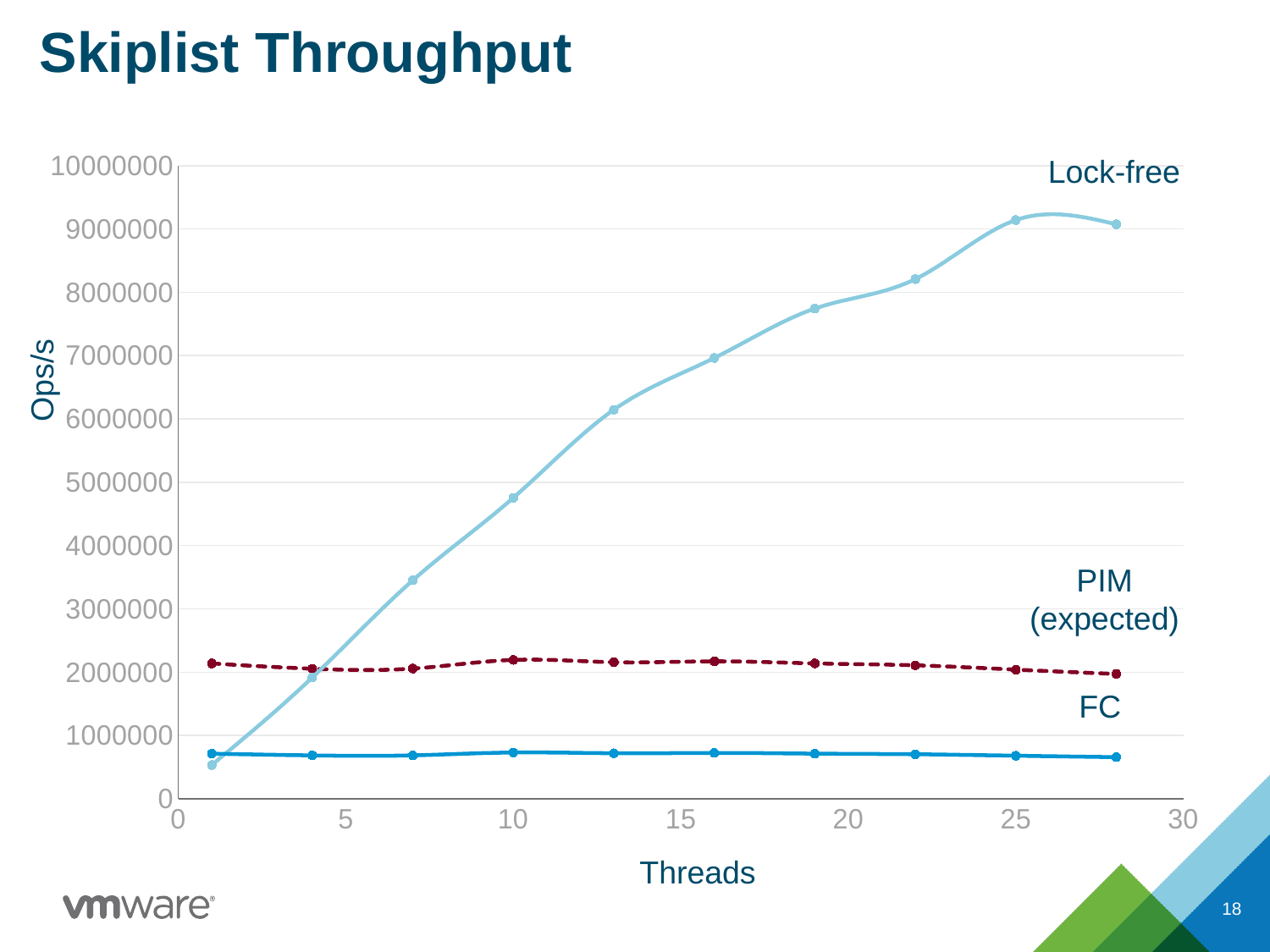
At 28 threads, which is larger: the Lock-free value or the FC value? Lock-free How many series are plotted on the chart? 3 Which series reaches the highest throughput on the chart? Lock-free Is the FC value at 1 thread greater or less than 1000000? less Does the Lock-free throughput generally rise or fall as the number of threads increases? rise At 1 thread, which is larger: the FC value or the Lock-free value? FC How many data points does the Lock-free series have? 10 What is the label of the y axis? Ops/s Is the Lock-free value at 10 threads greater or less than 5000000? less Is the Lock-free value at 25 threads greater or less than 9000000? greater What kind of chart is shown on the slide? line chart